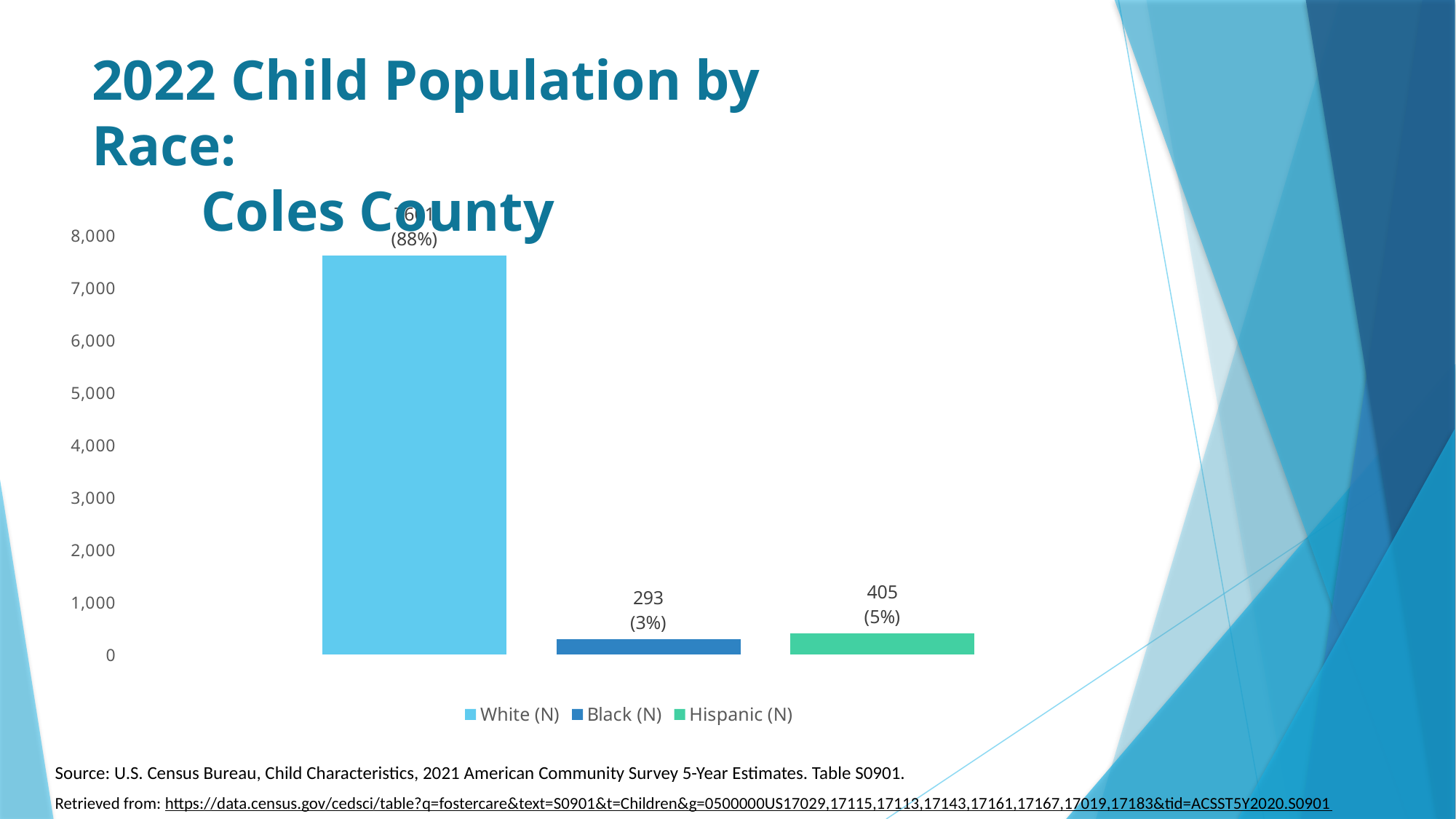
What percentage is shown for Black (N)? 3% How many series does the legend list? 3 Which group has the highest child population? White (N) Which is larger, the value for Hispanic (N) or Black (N)? Hispanic (N) What is the value shown for Hispanic (N)? 405 What kind of chart is shown on the slide? bar chart What is the difference between the Hispanic (N) and Black (N) values? 112 Which group has the lowest child population? Black (N) What percentage is shown for White (N)? 88% What is the value shown for Black (N)? 293 What percentage is shown for Hispanic (N)? 5% Is the value for White (N) greater or less than 7,000? greater